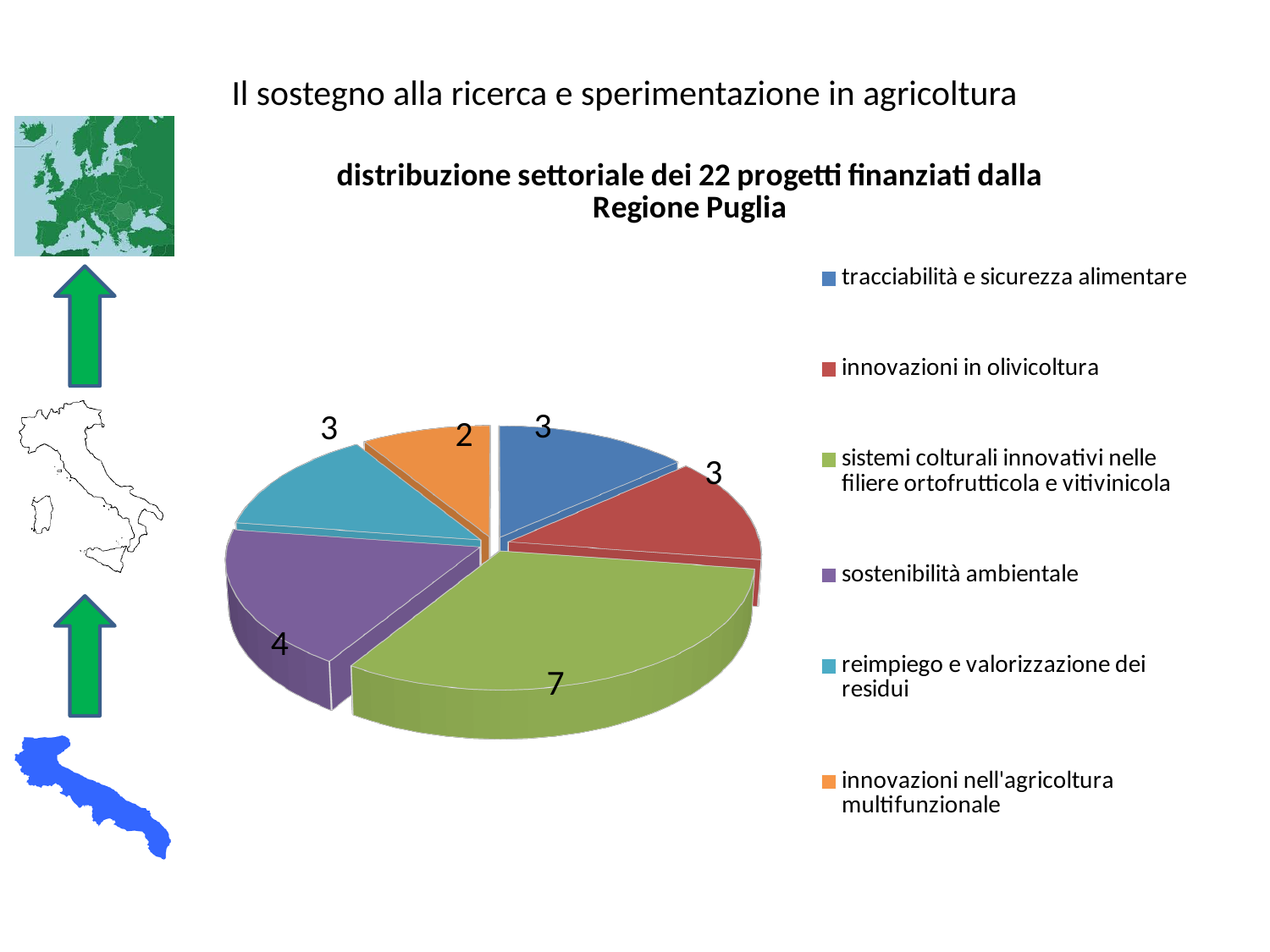
Which sector has the largest slice of the pie? sistemi colturali innovativi nelle filiere ortofrutticola e vitivinicola Which is larger: 'sostenibilità ambientale' or 'innovazioni in olivicoltura'? sostenibilità ambientale What is the value of the 'tracciabilità e sicurezza alimentare' slice? 3 How many sectors (slices) does the pie chart show? 6 What share of the 22 projects does the 'sistemi colturali innovativi nelle filiere ortofrutticola e vitivinicola' slice represent? 7 of 22 (31.8%) What is the difference between the 'sistemi colturali innovativi' slice and the 'sostenibilità ambientale' slice? 3 What is the value of the 'sostenibilità ambientale' slice? 4 Which sector has the smallest slice of the pie? innovazioni nell'agricoltura multifunzionale What kind of chart is shown on the slide? pie chart How many projects are in the 'sistemi colturali innovativi nelle filiere ortofrutticola e vitivinicola' slice? 7 What is the title of the pie chart? distribuzione settoriale dei 22 progetti finanziati dalla Regione Puglia What is the value of the 'innovazioni nell'agricoltura multifunzionale' slice? 2